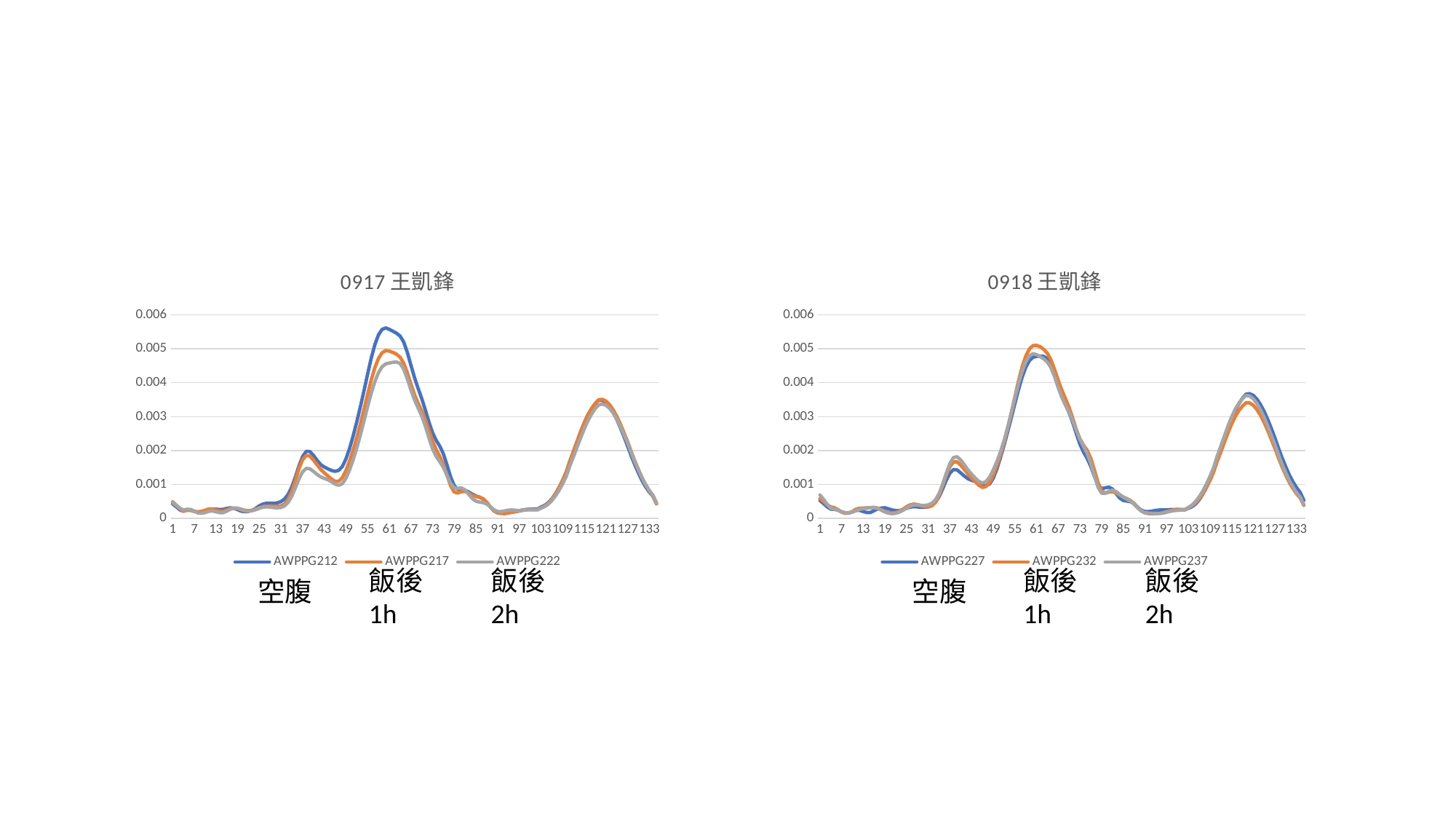
What kind of chart is the chart titled 0917 王凱鋒? line chart In the chart titled 0917 王凱鋒, is the peak value of AWPPG212 near x = 61 greater or less than 0.005? greater In the chart titled 0918 王凱鋒, which is larger at the peak near x = 121: AWPPG227 or AWPPG232? AWPPG227 In the chart titled 0918 王凱鋒, is the value of AWPPG227 near x = 37 greater or less than 0.002? less In the chart titled 0917 王凱鋒, is the value of AWPPG217 at its second peak near x = 121 greater or less than 0.003? greater In the chart titled 0917 王凱鋒, which series reaches the highest peak around x = 61? AWPPG212 How many series does the legend of the chart titled 0918 王凱鋒 list? 3 What are the legend entries of the chart titled 0917 王凱鋒? AWPPG212, AWPPG217, AWPPG222 In the chart titled 0917 王凱鋒, which is larger at the peak near x = 61: AWPPG212 or AWPPG222? AWPPG212 What is the highest value shown on the y axis of the chart titled 0918 王凱鋒? 0.006